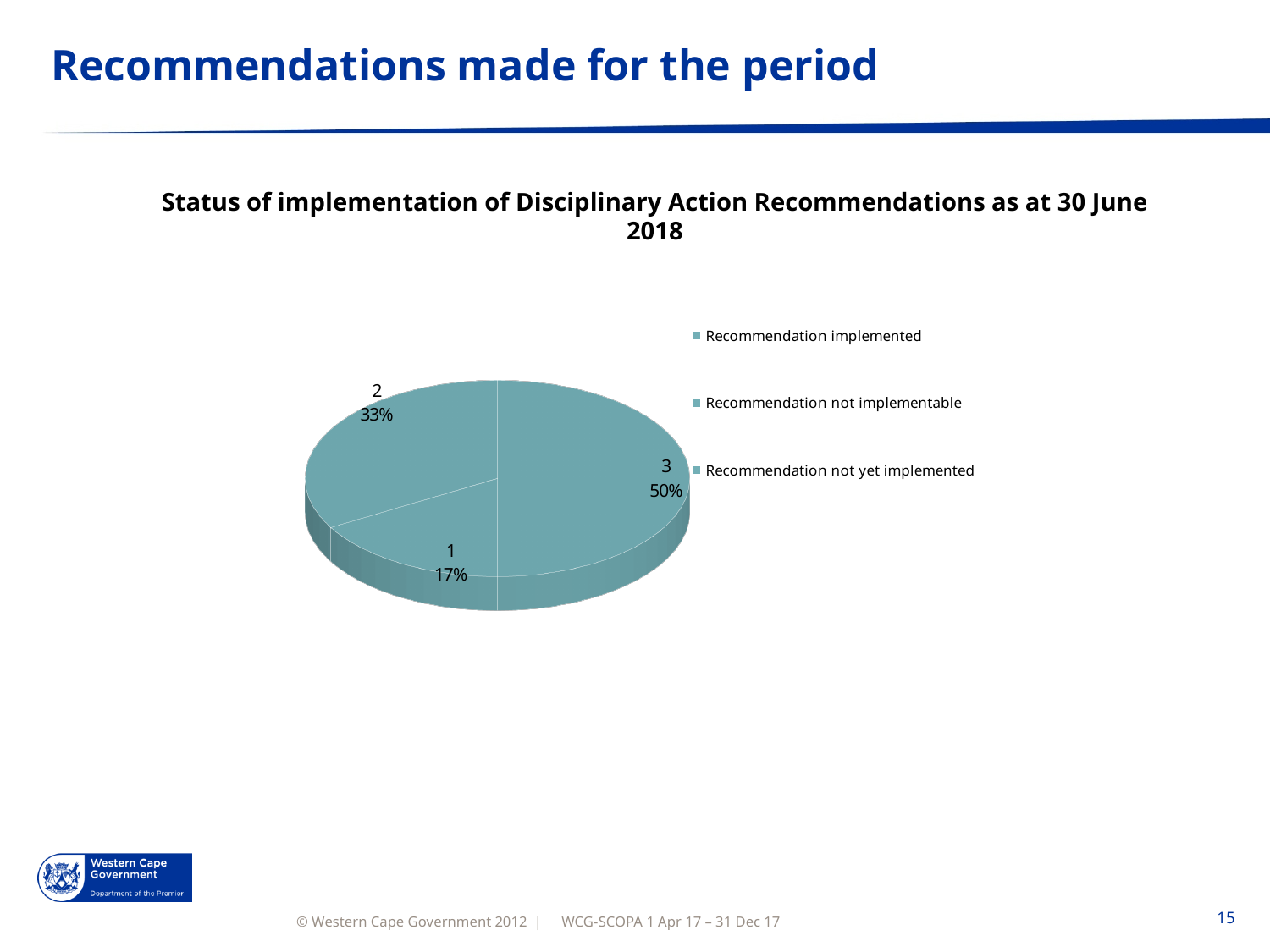
What is the count shown on the slice labelled 50%? 3 What share of the pie does the largest slice represent? 50% How many slices does the pie chart have? 3 What is the difference between the largest slice count (3) and the smallest slice count (1)? 2 Which legend entry is listed last? Recommendation not yet implemented What is the title of the chart? Status of implementation of Disciplinary Action Recommendations as at 30 June 2018 How many entries does the legend list? 3 What type of chart is shown on the slide? Pie chart What percentage is shown on the slice with a count of 2? 33% What percentage is shown on the slice with a count of 1? 17% What share of the pie does the smallest slice represent? 17% What is the total of the counts shown on all slices of the pie? 6